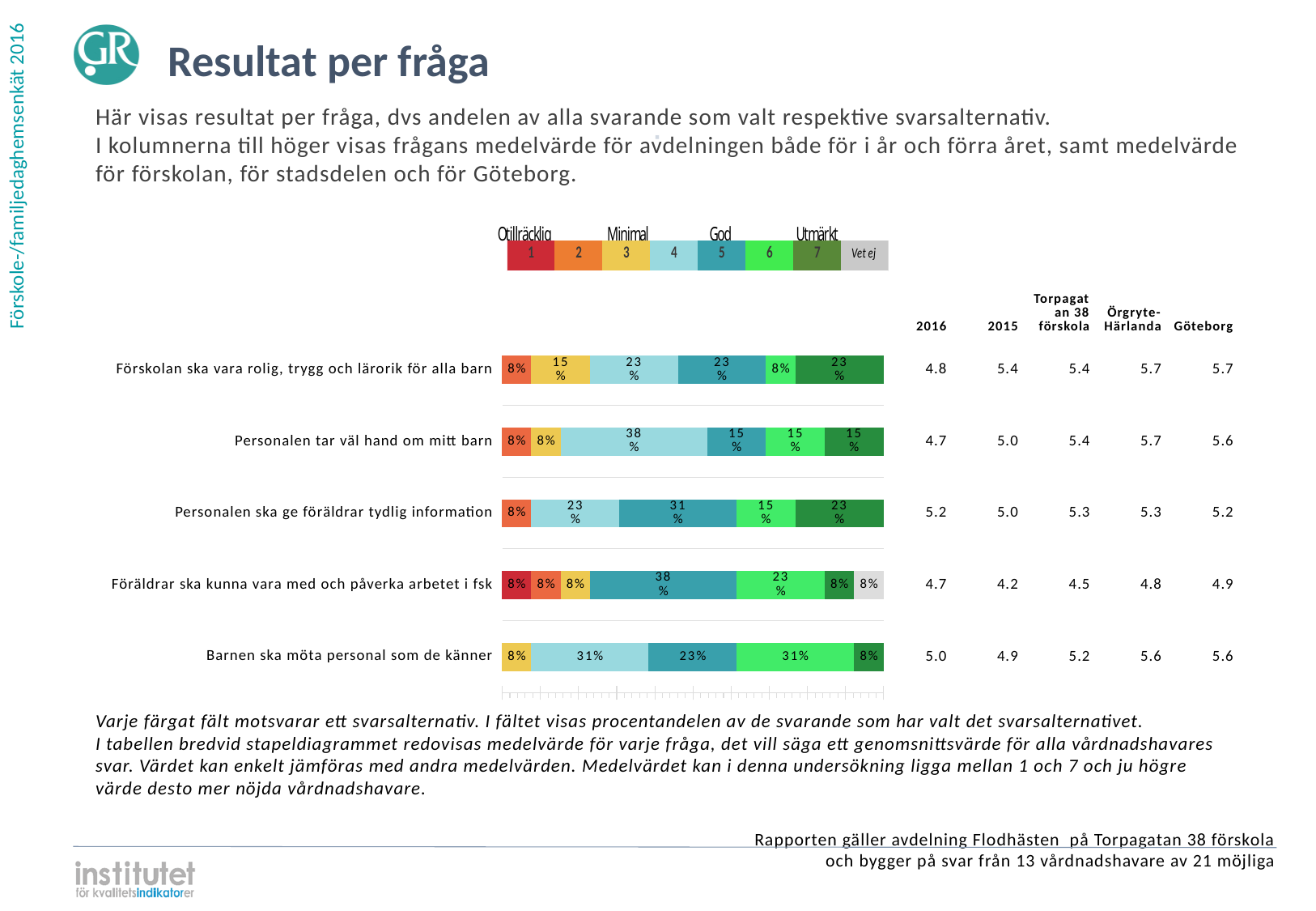
What share of respondents chose alternative 7 (dark green) for 'Förskolan ska vara rolig, trygg och lärorik för alla barn'? 23% How many answer alternatives does the legend above the chart list, including 'Vet ej'? 8 What is the 2016 mean value shown for 'Personalen ska ge föräldrar tydlig information'? 5.2 Which question is the only one with a share for alternative 1 (red)? Föräldrar ska kunna vara med och påverka arbetet i fsk What share of respondents chose alternative 4 (light blue) for 'Personalen tar väl hand om mitt barn'? 38% For 'Barnen ska möta personal som de känner', which is larger: the share for alternative 4 or the share for alternative 5? Alternative 4 (31%) What share of respondents answered 'Vet ej' for 'Föräldrar ska kunna vara med och påverka arbetet i fsk'? 8% Which answer alternative has the largest share for 'Personalen ska ge föräldrar tydlig information'? 5 (31%) Which question has the lowest 2016 mean value in the table next to the chart? Personalen tar väl hand om mitt barn and Föräldrar ska kunna vara med och påverka arbetet i fsk (both 4.7) What kind of chart is used to show the results per question? Stacked bar chart What is the difference between the share for alternative 5 (38%) and alternative 6 (23%) for 'Föräldrar ska kunna vara med och påverka arbetet i fsk'? 15 percentage points How many questions (categories) are shown in the bar chart? 5